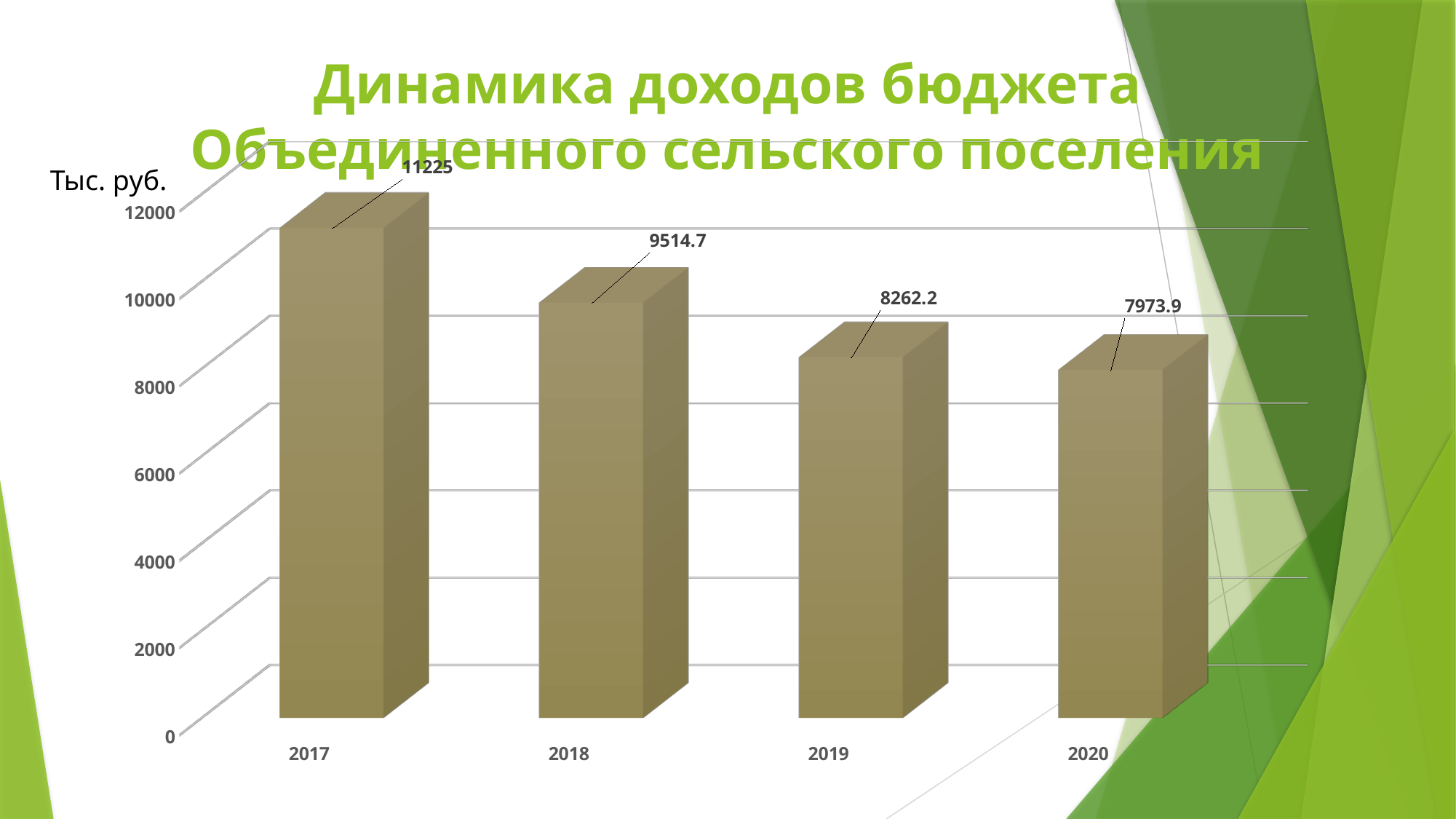
Which is larger, the value for 2018 or the value for 2019? 2018 Which year has the lowest value? 2020 What is the value for 2017? 11225 How many years are shown on the x axis? 4 What is the value for 2019? 8262.2 What is the difference between the values for 2017 and 2018? 1710.3 What kind of chart is this? bar chart What is the value for 2018? 9514.7 What is the value for 2020? 7973.9 Which year has the highest value? 2017 What is the difference between the values for 2019 and 2020? 288.3 Do the values rise or fall from 2017 to 2020? fall